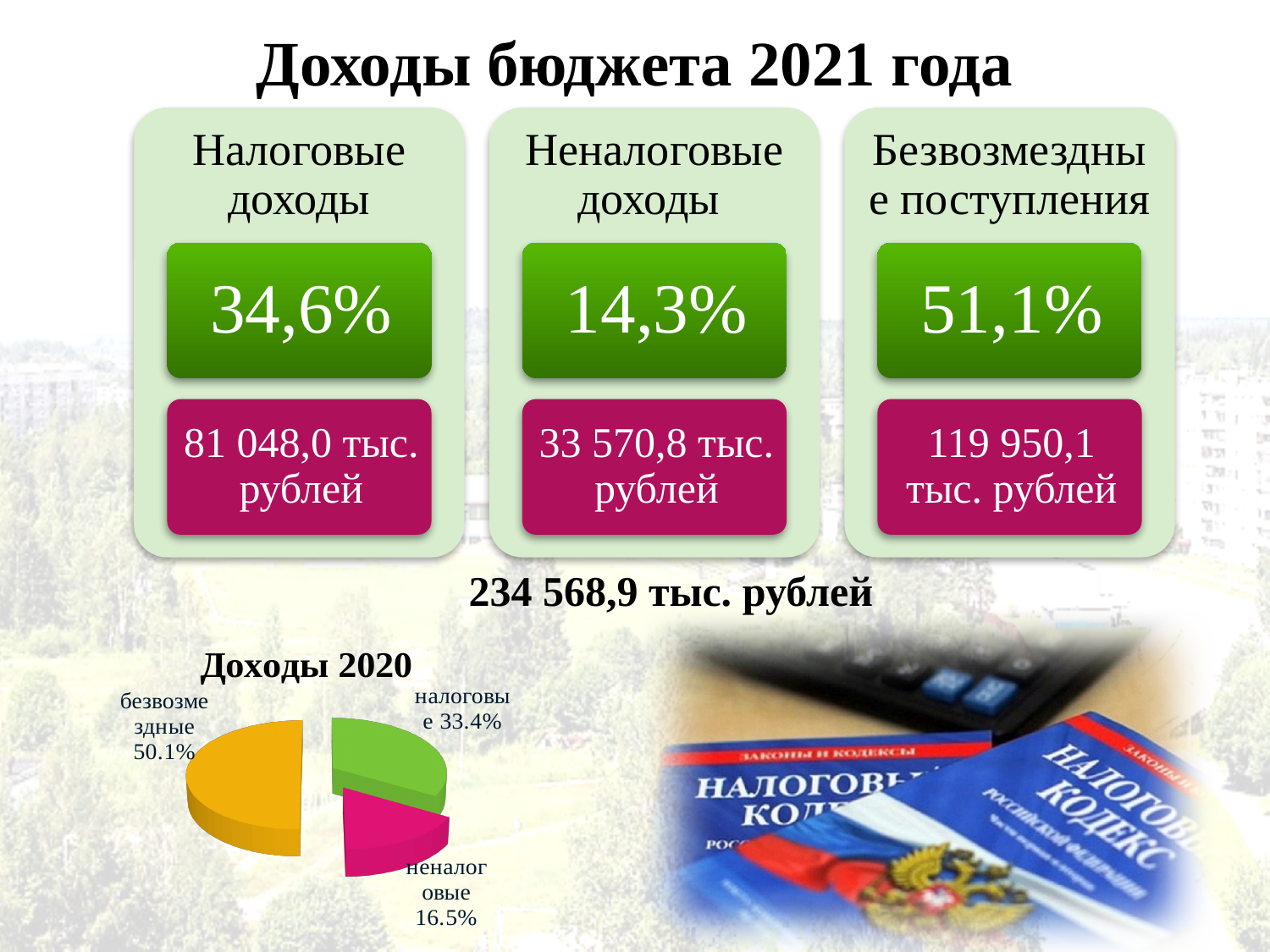
In the "Доходы 2020" pie chart, which category has the smallest slice? неналоговые In the "Доходы 2020" pie chart, what share is labelled for неналоговые? 16.5% What is the title of the pie chart on the slide? Доходы 2020 In the "Доходы 2020" pie chart, what share is labelled for безвозмездные? 50.1% In the "Доходы 2020" pie chart, what is the difference in percentage points between налоговые and неналоговые? 16.9 In the "Доходы 2020" pie chart, which is larger: налоговые or неналоговые? налоговые In the "Доходы 2020" pie chart, what colour is the безвозмездные slice? yellow In the "Доходы 2020" pie chart, what share is labelled for налоговые? 33.4% In the "Доходы 2020" pie chart, how many slices are there? 3 In the "Доходы 2020" pie chart, what is the difference in percentage points between безвозмездные and налоговые? 16.7 In the "Доходы 2020" pie chart, which category has the largest slice? безвозмездные What kind of chart is shown under the heading "Доходы 2020"? pie chart